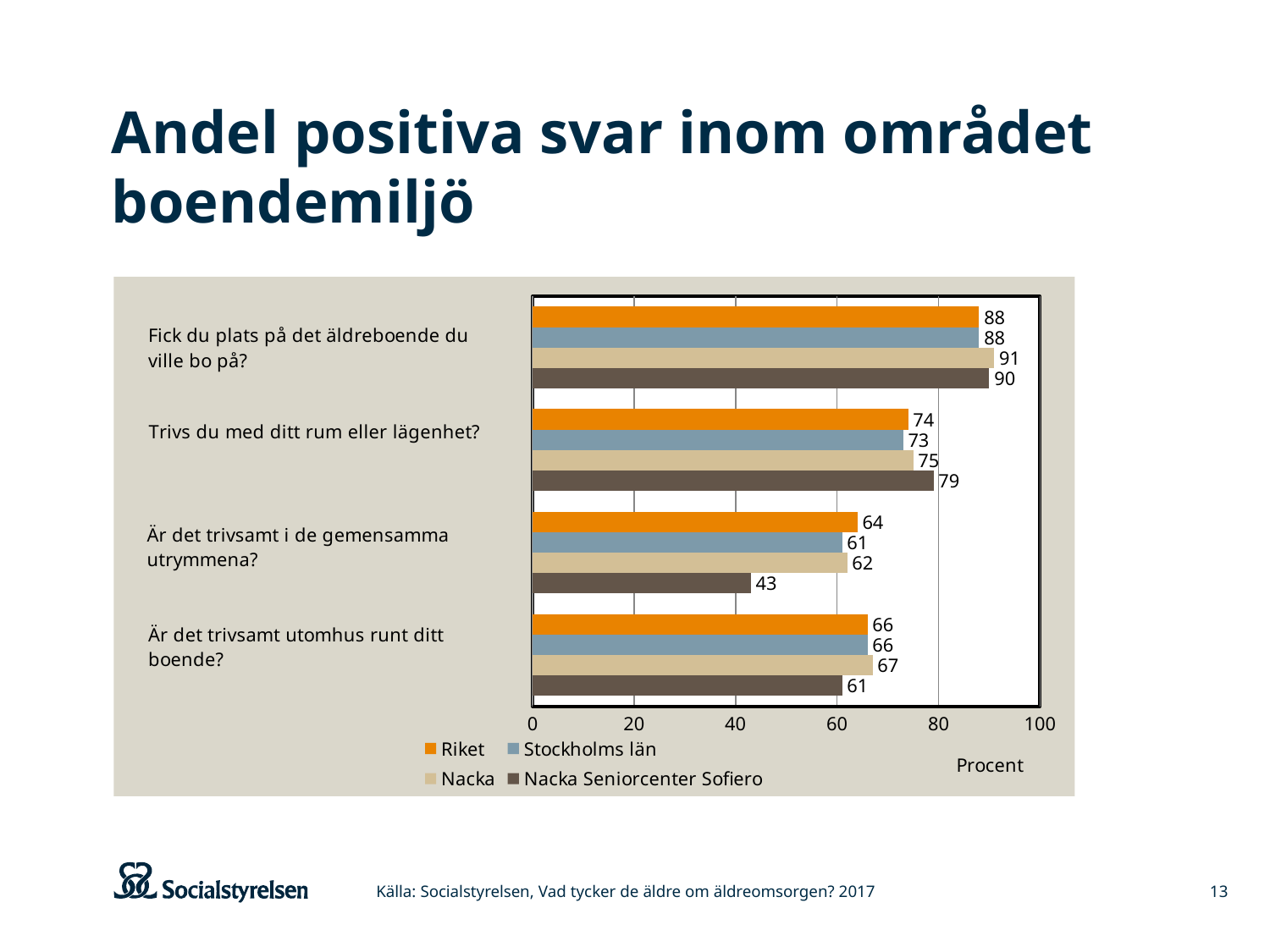
For "Är det trivsamt utomhus runt ditt boende?", which is larger: the value for Nacka or the value for Nacka Seniorcenter Sofiero? Nacka What label is shown on the horizontal axis of the chart? Procent Which series has the lowest value for "Är det trivsamt i de gemensamma utrymmena?"? Nacka Seniorcenter Sofiero What is the value for Riket for "Trivs du med ditt rum eller lägenhet?"? 74 What is the value for Stockholms län for "Är det trivsamt utomhus runt ditt boende?"? 66 How many series does the legend list? 4 Which series has the highest value for "Trivs du med ditt rum eller lägenhet?"? Nacka Seniorcenter Sofiero What kind of chart is shown on the slide? Bar chart What is the value for Nacka Seniorcenter Sofiero for "Är det trivsamt i de gemensamma utrymmena?"? 43 What is the value for Nacka for "Fick du plats på det äldreboende du ville bo på?"? 91 How many question categories are plotted on the chart? 4 What is the difference between the Riket value and the Nacka Seniorcenter Sofiero value for "Är det trivsamt i de gemensamma utrymmena?"? 21